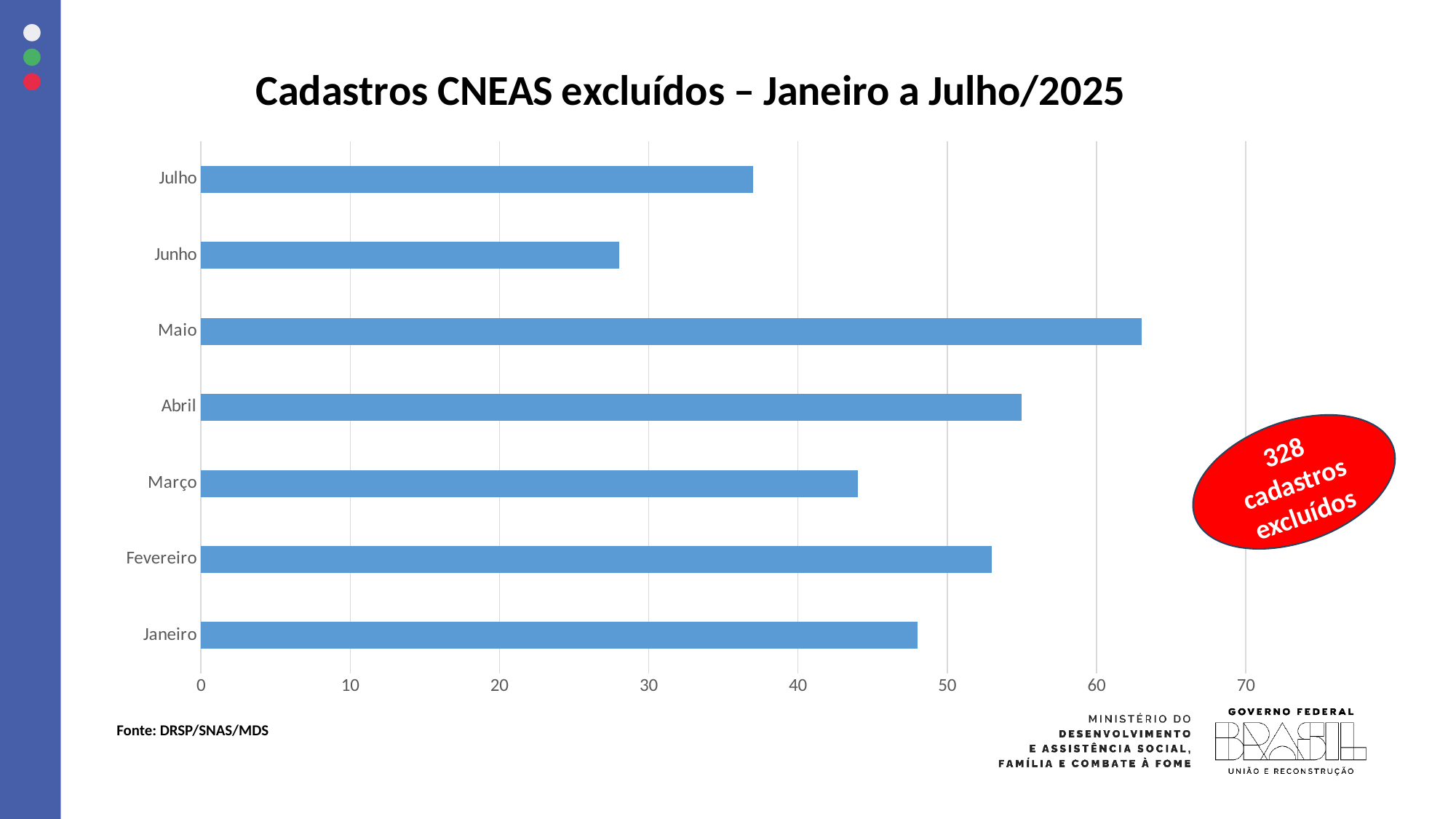
Is the value for Maio greater or less than 60? greater How many months are plotted in the chart? 7 What is the title of the chart? Cadastros CNEAS excluídos – Janeiro a Julho/2025 Is the value for Junho greater or less than 30? less Which is larger, the value for Julho or the value for Março? Março Is the value for Abril greater or less than 50? greater What kind of chart is shown on the slide? bar chart Which month has the lowest number of excluded CNEAS registrations? Junho Which is larger, the value for Abril or the value for Janeiro? Abril Which month has the highest number of excluded CNEAS registrations? Maio What total number of excluded registrations is shown in the red callout on the slide? 328